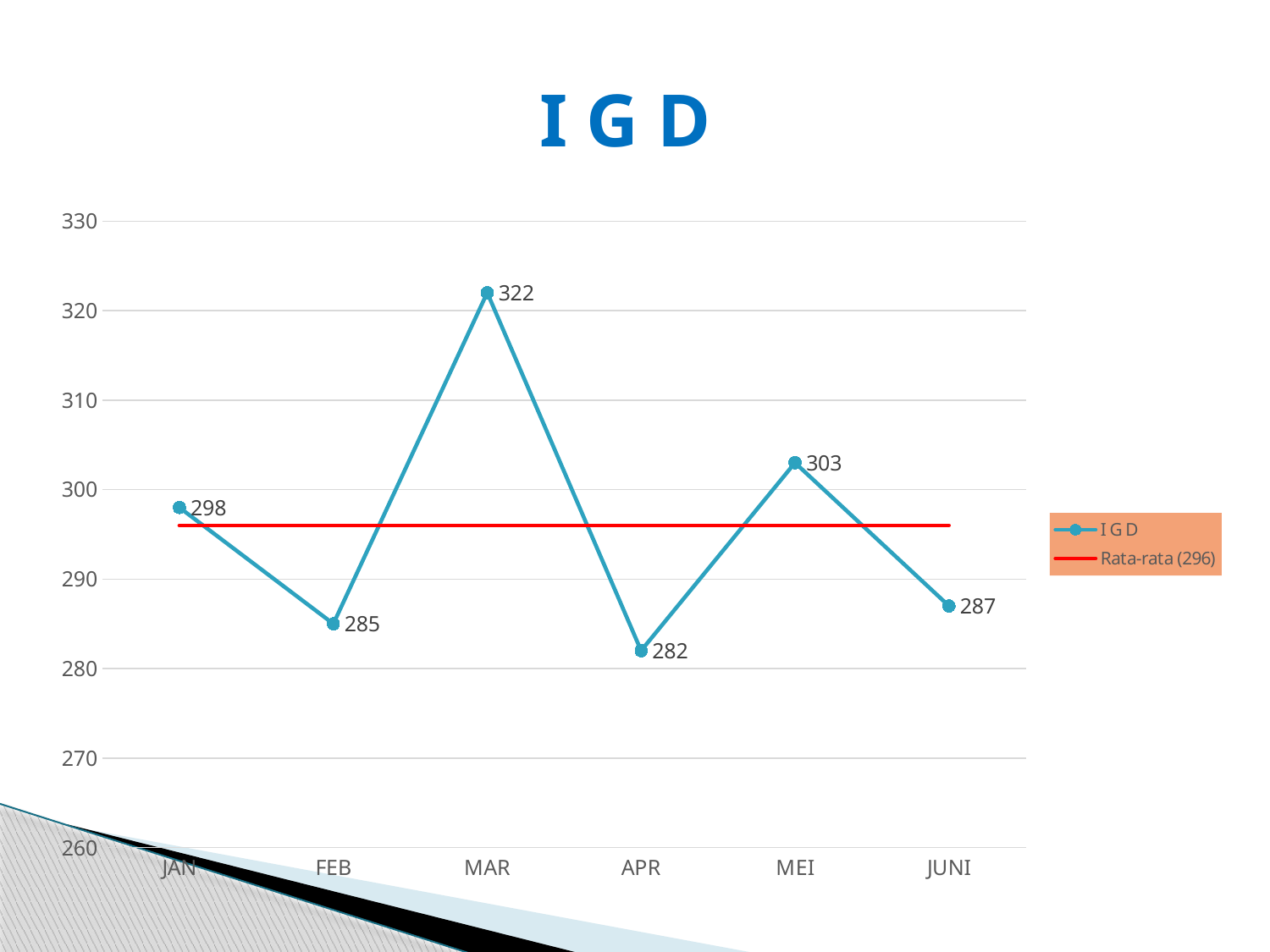
What is the I G D value for JUNI? 287 What kind of chart is shown on the slide? line chart Which month has the highest I G D value? MAR Does the I G D value rise or fall from MEI to JUNI? fall What is the difference between the I G D values for MAR and APR? 40 What value does the red Rata-rata line represent according to the legend? 296 What is the I G D value for MAR? 322 How many months are plotted on the x axis? 6 Which is larger, the I G D value for JAN or for FEB? JAN Which month has the lowest I G D value? APR Is the I G D value for MEI greater or less than 300? greater How many series does the legend list? 2